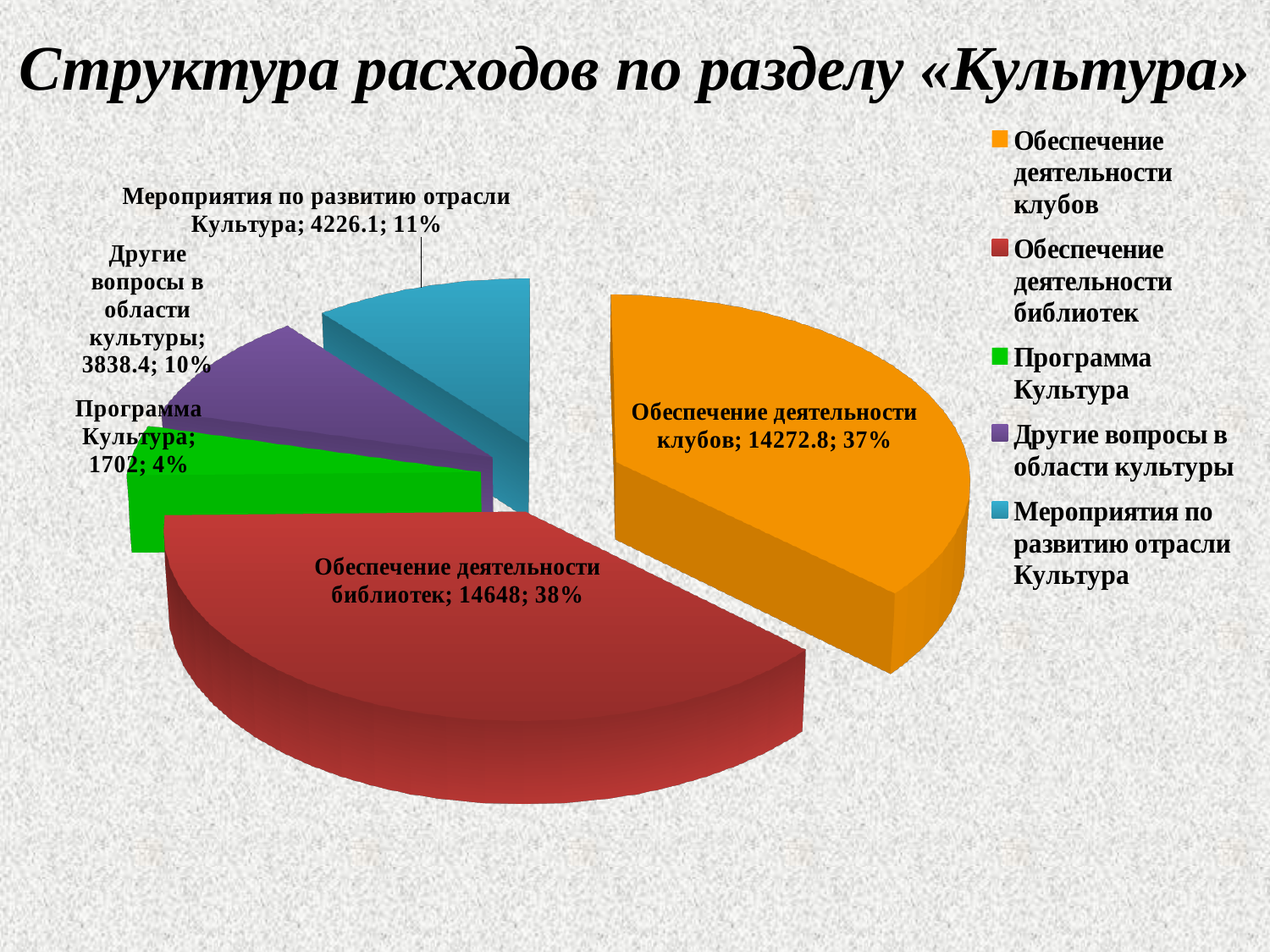
How many slices does the pie chart have? 5 What is the difference between the values for Мероприятия по развитию отрасли Культура and Другие вопросы в области культуры? 387.7 What share of the pie does Мероприятия по развитию отрасли Культура take? 11% What is the value for Программа Культура? 1702 What is the value for Другие вопросы в области культуры? 3838.4 What is the title of the chart? Структура расходов по разделу «Культура» What is the value for Обеспечение деятельности библиотек? 14648 What kind of chart is shown on the slide? pie chart Which category has the largest value? Обеспечение деятельности библиотек Which category has the smallest value? Программа Культура What share of the pie does Обеспечение деятельности библиотек take? 38% What is the value for Обеспечение деятельности клубов? 14272.8